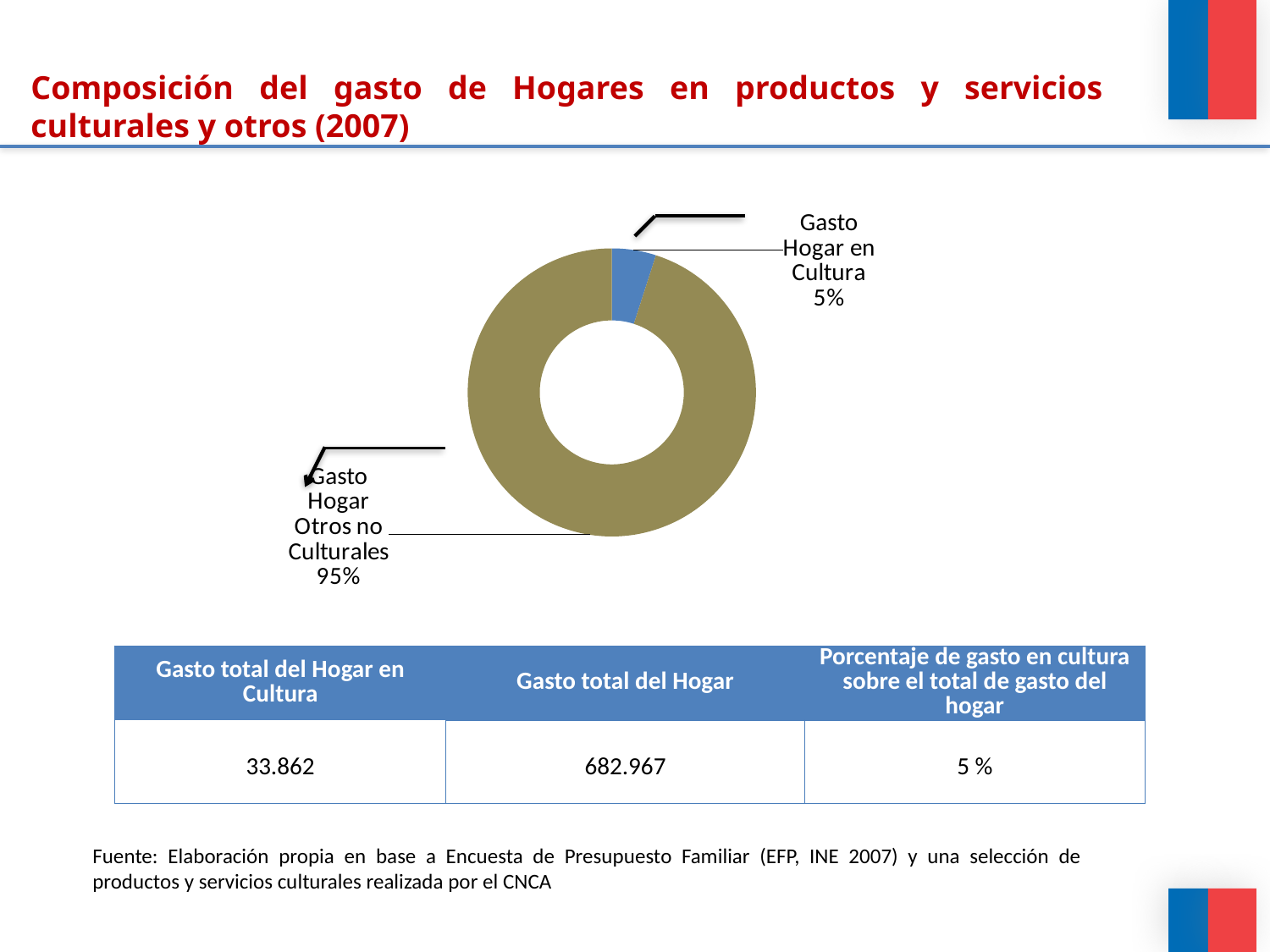
What colour is the 'Gasto Hogar en Cultura' slice? Blue What is the difference in percentage points between the 'Gasto Hogar Otros no Culturales' slice and the 'Gasto Hogar en Cultura' slice? 90 percentage points Which is larger, the 'Gasto Hogar en Cultura' slice or the 'Gasto Hogar Otros no Culturales' slice? Gasto Hogar Otros no Culturales What kind of chart is shown on the slide? Doughnut (pie) chart How many slices does the chart have? 2 Which slice of the chart is the largest? Gasto Hogar Otros no Culturales What colour is the 'Gasto Hogar Otros no Culturales' slice? Olive/khaki What share of household spending does 'Gasto Hogar Otros no Culturales' represent? 95% What share of household spending does 'Gasto Hogar en Cultura' represent? 5% Which slice of the chart is the smallest? Gasto Hogar en Cultura